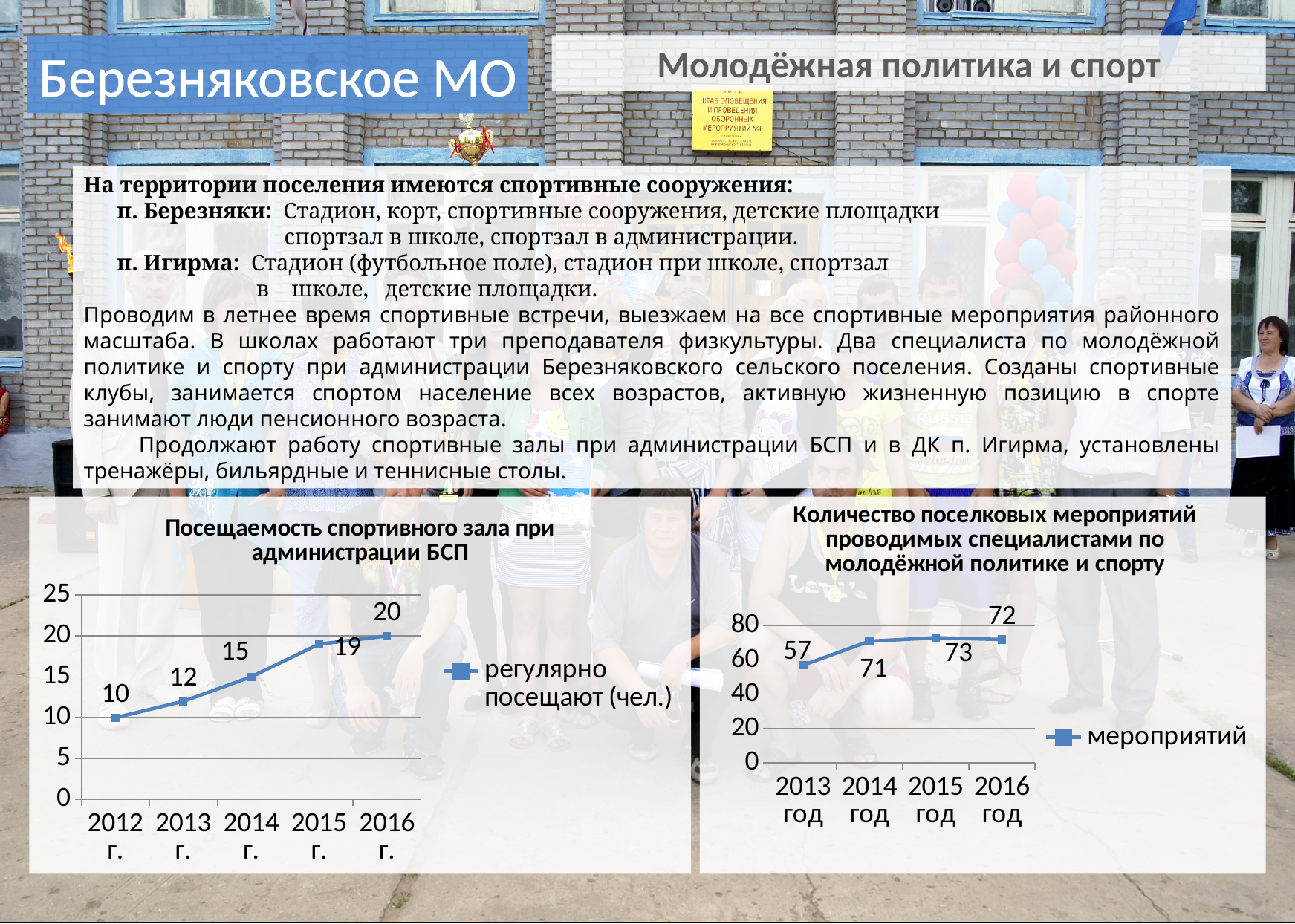
On the left chart (Посещаемость спортивного зала при администрации БСП), what kind of chart is it? line chart On the right chart (Количество поселковых мероприятий), what is the value for 2015 год? 73 On the left chart (Посещаемость спортивного зала при администрации БСП), what is the difference between the values for 2016 г. and 2012 г.? 10 On the right chart (Количество поселковых мероприятий), what is the legend entry for the plotted series? мероприятий On the right chart (Количество поселковых мероприятий), which year has the lowest value? 2013 год On the right chart (Количество поселковых мероприятий), what is the difference between the values for 2014 год and 2013 год? 14 On the left chart (Посещаемость спортивного зала при администрации БСП), what is the value for 2014 г.? 15 On the left chart (Посещаемость спортивного зала при администрации БСП), do the values rise or fall from 2012 г. to 2016 г.? rise On the left chart (Посещаемость спортивного зала при администрации БСП), how many years are plotted on the x axis? 5 On the left chart (Посещаемость спортивного зала при администрации БСП), which year has the lowest value? 2012 г. On the right chart (Количество поселковых мероприятий), what is the value for 2013 год? 57 On the left chart (Посещаемость спортивного зала при администрации БСП), what is the value for 2016 г.? 20